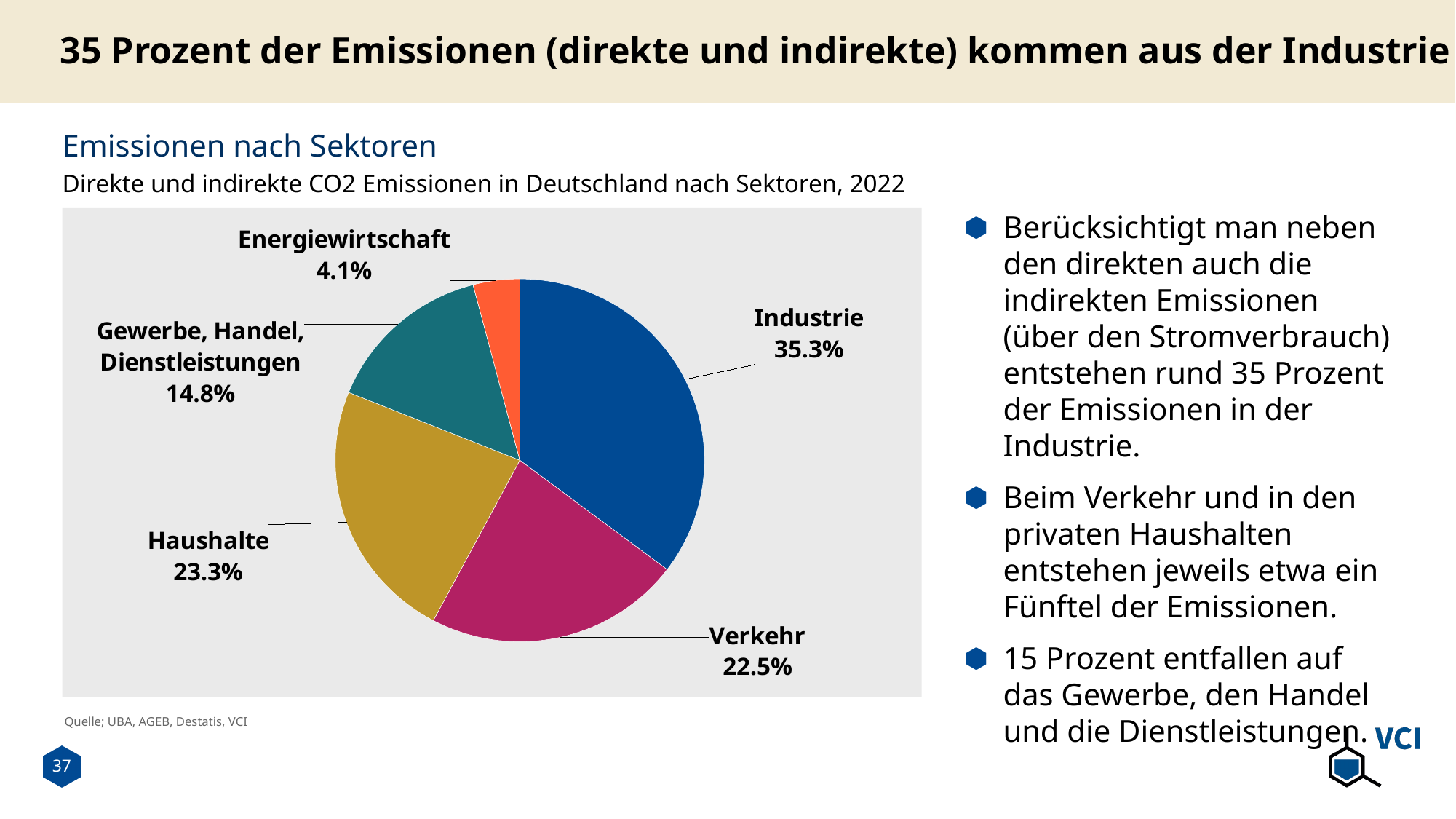
How many sectors are shown in the pie chart? 5 What kind of chart is shown on the slide? Pie chart What share of emissions is attributed to Haushalte? 23.3% What is the title of the chart? Emissionen nach Sektoren Which sector has the smallest share of emissions? Energiewirtschaft Which has a larger share, Haushalte or Verkehr? Haushalte What share of emissions is attributed to Verkehr? 22.5% What share of emissions is attributed to Energiewirtschaft? 4.1% Which sector has the largest share of emissions? Industrie What share of emissions is attributed to Gewerbe, Handel, Dienstleistungen? 14.8% What is the difference in percentage points between the Industrie share and the Haushalte share? 12.0 What share of emissions does the Industrie slice represent? 35.3%